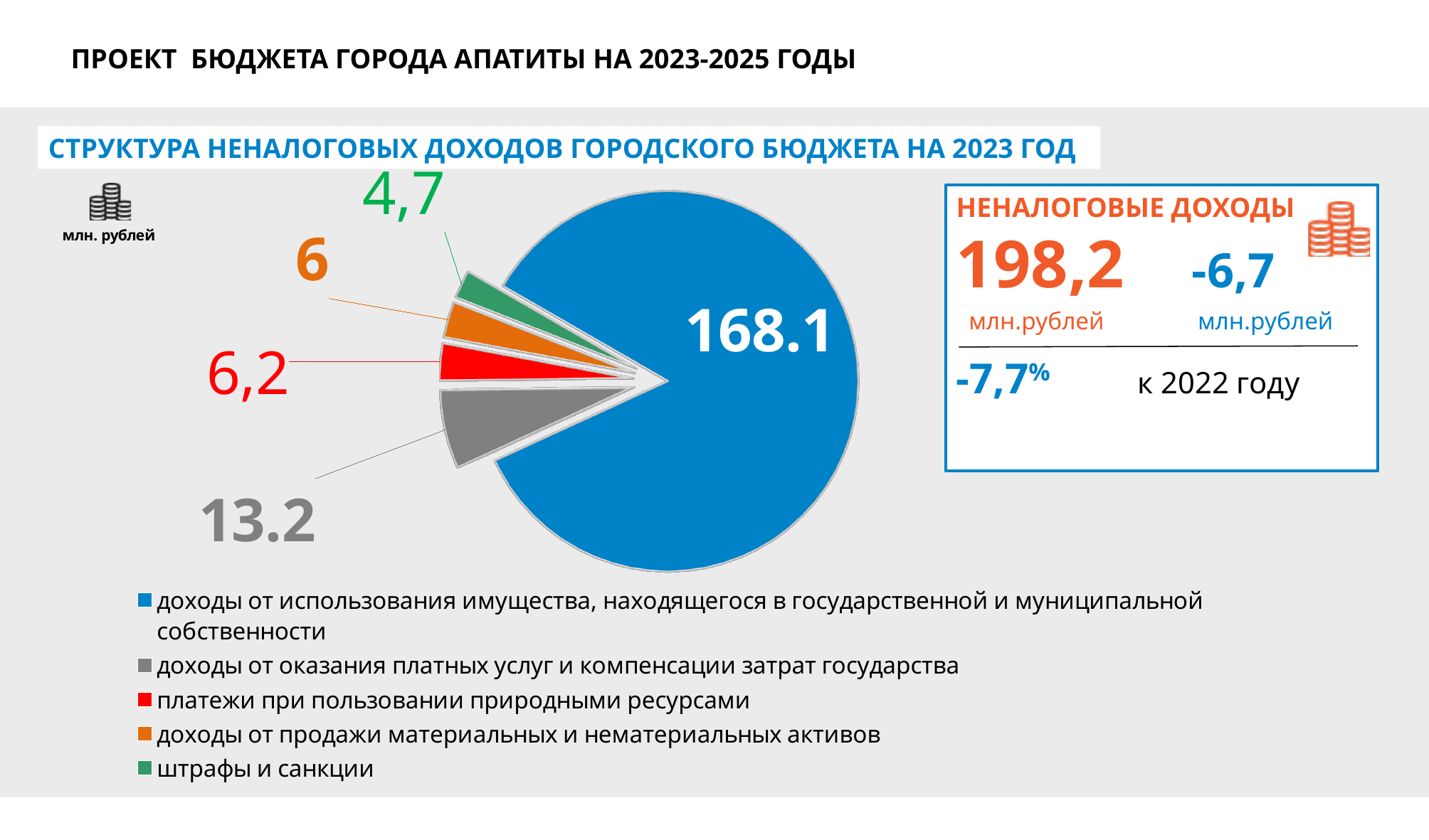
What is the difference between the values for «платежи при пользовании природными ресурсами» (6,2) and «штрафы и санкции» (4,7)? 1,5 What kind of chart is shown on the slide? pie chart How many slices does the pie chart have? 5 What is the value of the slice for «доходы от использования имущества, находящегося в государственной и муниципальной собственности»? 168.1 Which is larger: the slice for «платежи при пользовании природными ресурсами» or the slice for «доходы от продажи материальных и нематериальных активов»? платежи при пользовании природными ресурсами What is the difference between the values for «доходы от использования имущества» (168.1) and «доходы от оказания платных услуг» (13.2)? 154.9 What is the value of the slice for «доходы от оказания платных услуг и компенсации затрат государства»? 13.2 What colour is the slice for «доходы от оказания платных услуг и компенсации затрат государства»? grey Which category has the smallest slice in the pie chart? штрафы и санкции Which category has the largest slice in the pie chart? доходы от использования имущества, находящегося в государственной и муниципальной собственности What is the value of the slice for «штрафы и санкции»? 4,7 What is the value of the slice for «платежи при пользовании природными ресурсами»? 6,2